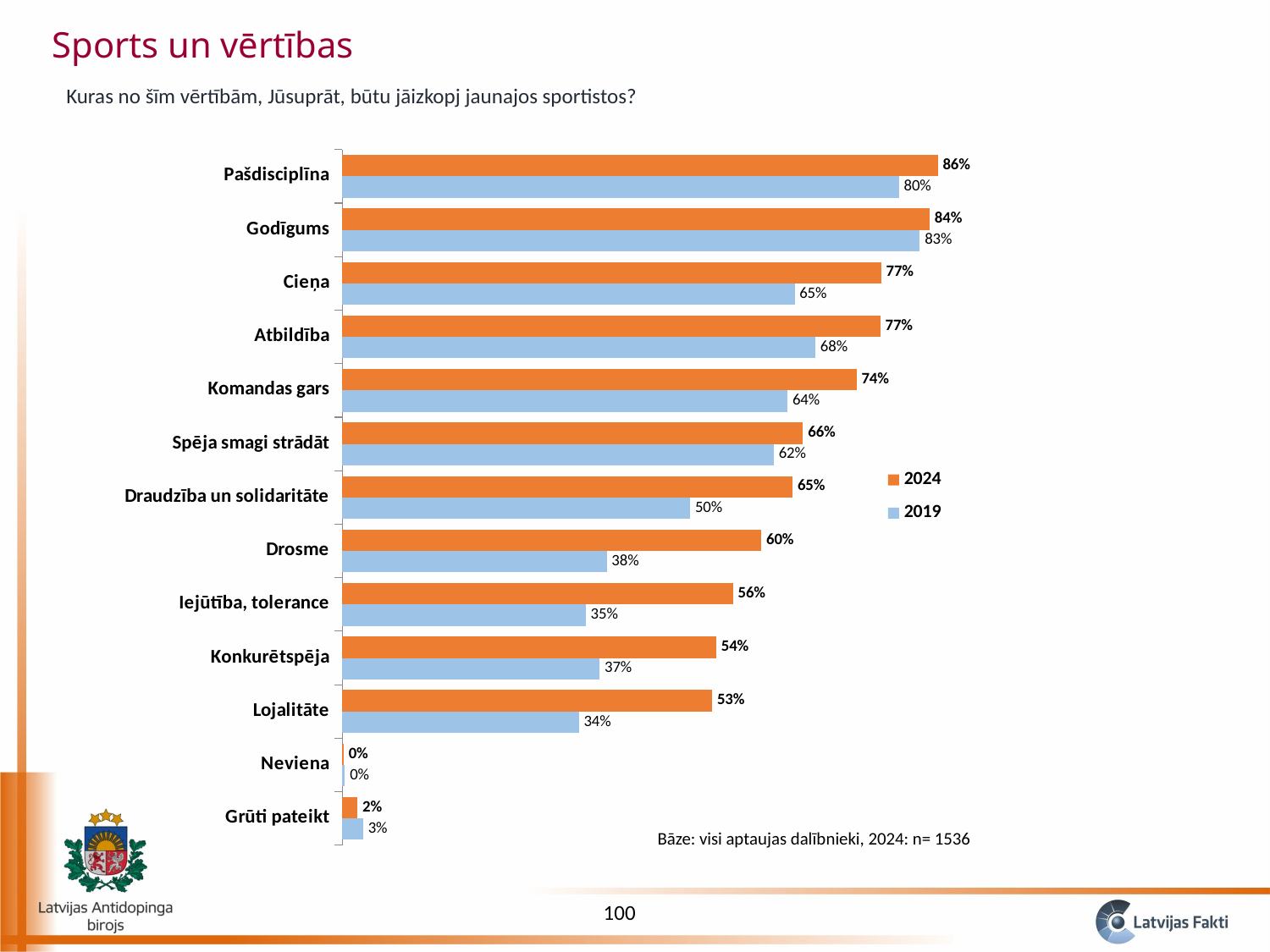
Which is larger: the 2019 value for Lojalitāte or the 2019 value for Konkurētspēja? Konkurētspēja What is the 2019 value for Draudzība un solidaritāte? 50% How many series does the legend list? 2 How many categories are shown on the chart? 13 What is the 2024 value for Pašdisciplīna? 86% What is the 2019 value for Drosme? 38% What is the difference between the 2024 and 2019 values for Iejūtība, tolerance? 21% Which is larger: the 2024 value for Komandas gars or the 2024 value for Spēja smagi strādāt? Komandas gars What kind of chart is shown on the slide? Bar chart Which category has the highest 2024 value? Pašdisciplīna What is the difference between the 2024 and 2019 values for Drosme? 22% Which category has the highest 2019 value? Godīgums